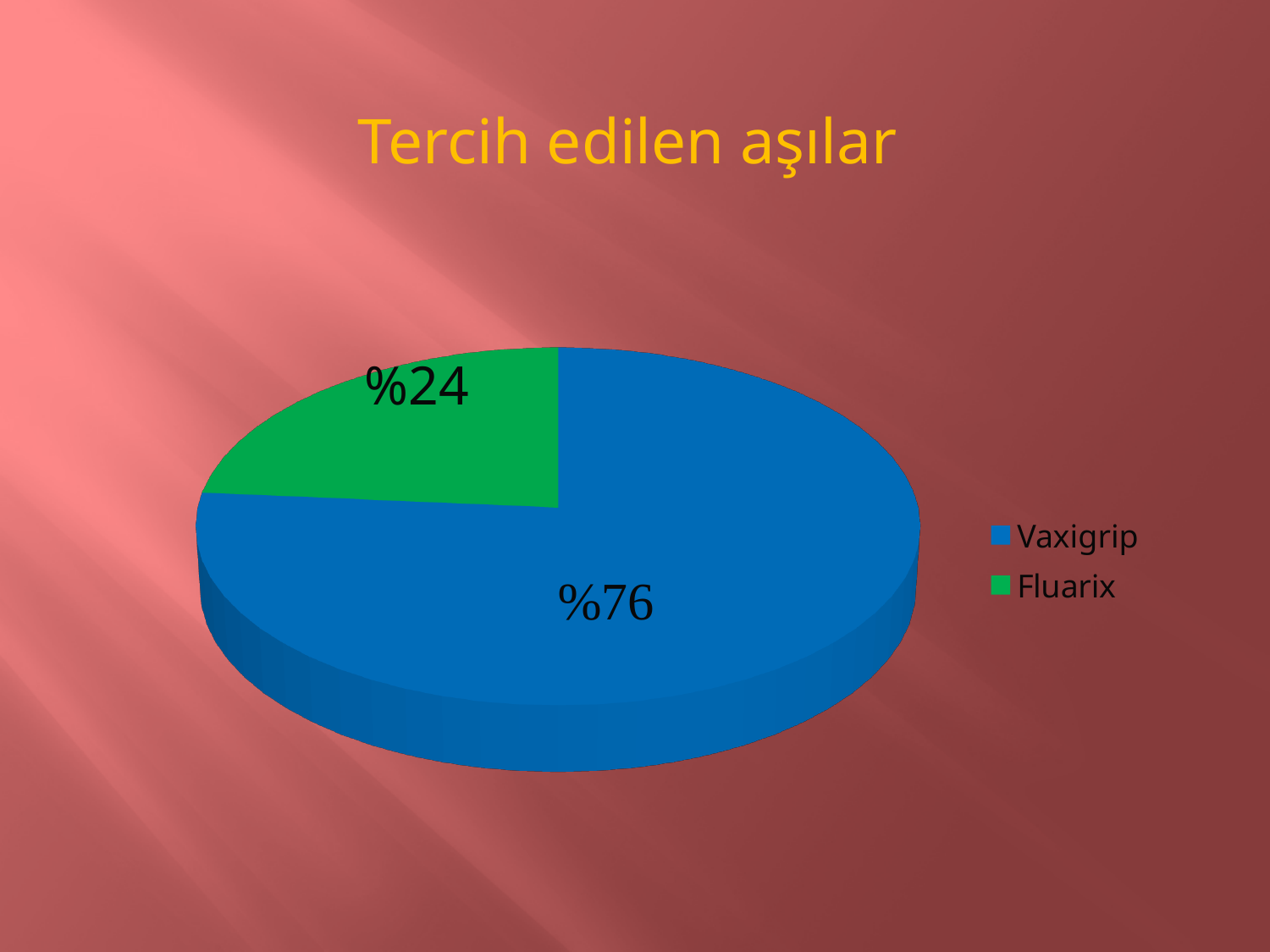
What share of the pie does Vaxigrip have? %76 What colour is the Fluarix slice? green What is the difference between the Vaxigrip and Fluarix shares? 52 percentage points How many entries does the legend list? 2 How many slices does the pie chart have? 2 What kind of chart is shown on the slide? pie chart What is the title of the chart? Tercih edilen aşılar Which is larger, Vaxigrip or Fluarix? Vaxigrip Which slice is the largest? Vaxigrip What share of the pie does Fluarix have? %24 Which slice is the smallest? Fluarix